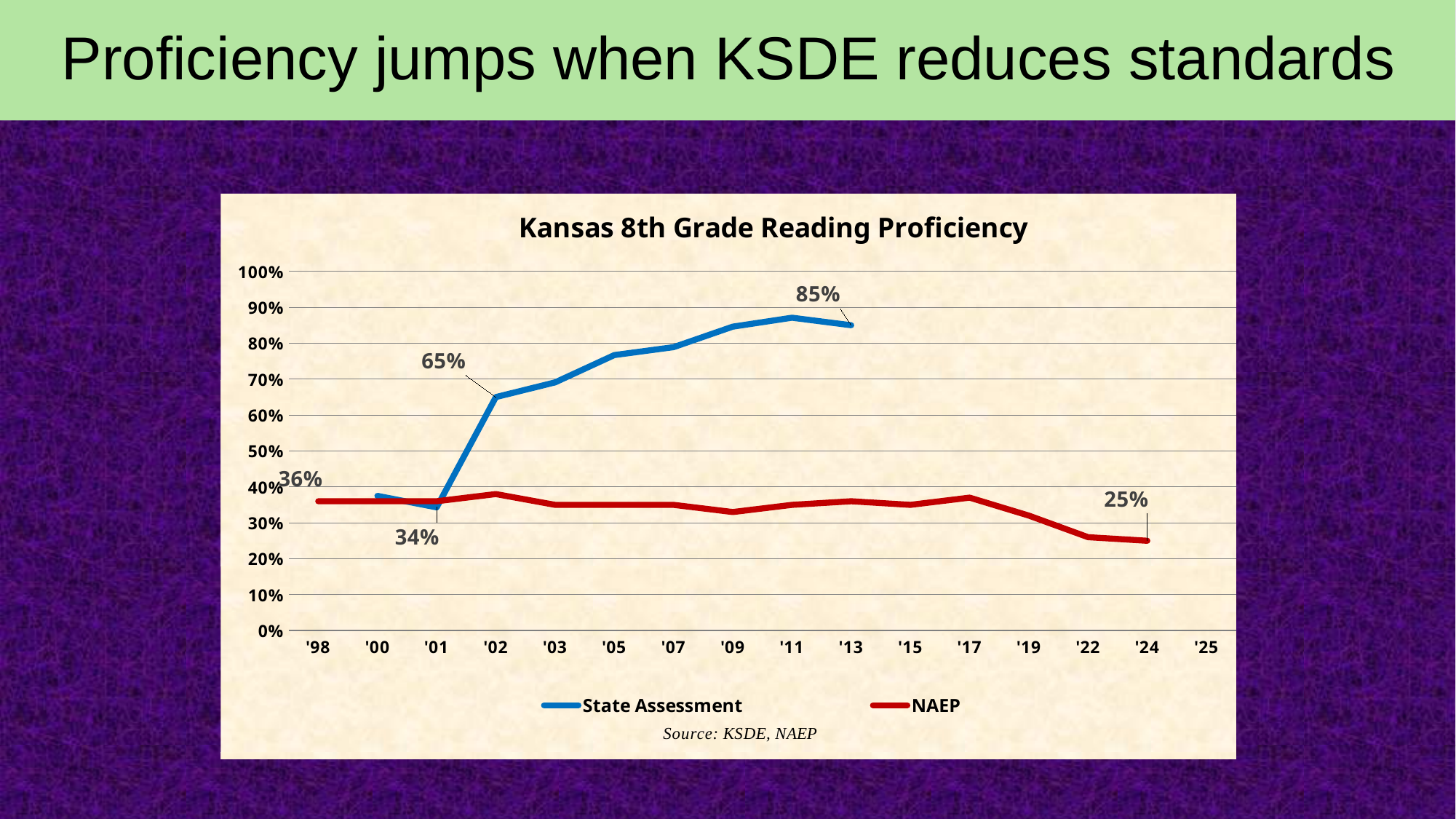
What is the State Assessment value for '02? 65% Which is larger: the State Assessment value in '13 or the NAEP value in '24? State Assessment in '13 What is the State Assessment value for '01? 34% What is the NAEP value for '98? 36% Is the State Assessment value for '11 greater or less than 80%? greater How many series does the legend list? 2 What kind of chart is shown on the slide? Line chart By how many percentage points did the State Assessment value rise from '01 to '02? 31 percentage points What is the NAEP value for '24? 25% Does the NAEP line rise or fall from '17 to '24? Fall What is the difference between the NAEP value in '98 and in '24? 11 percentage points What is the State Assessment value for '13? 85%